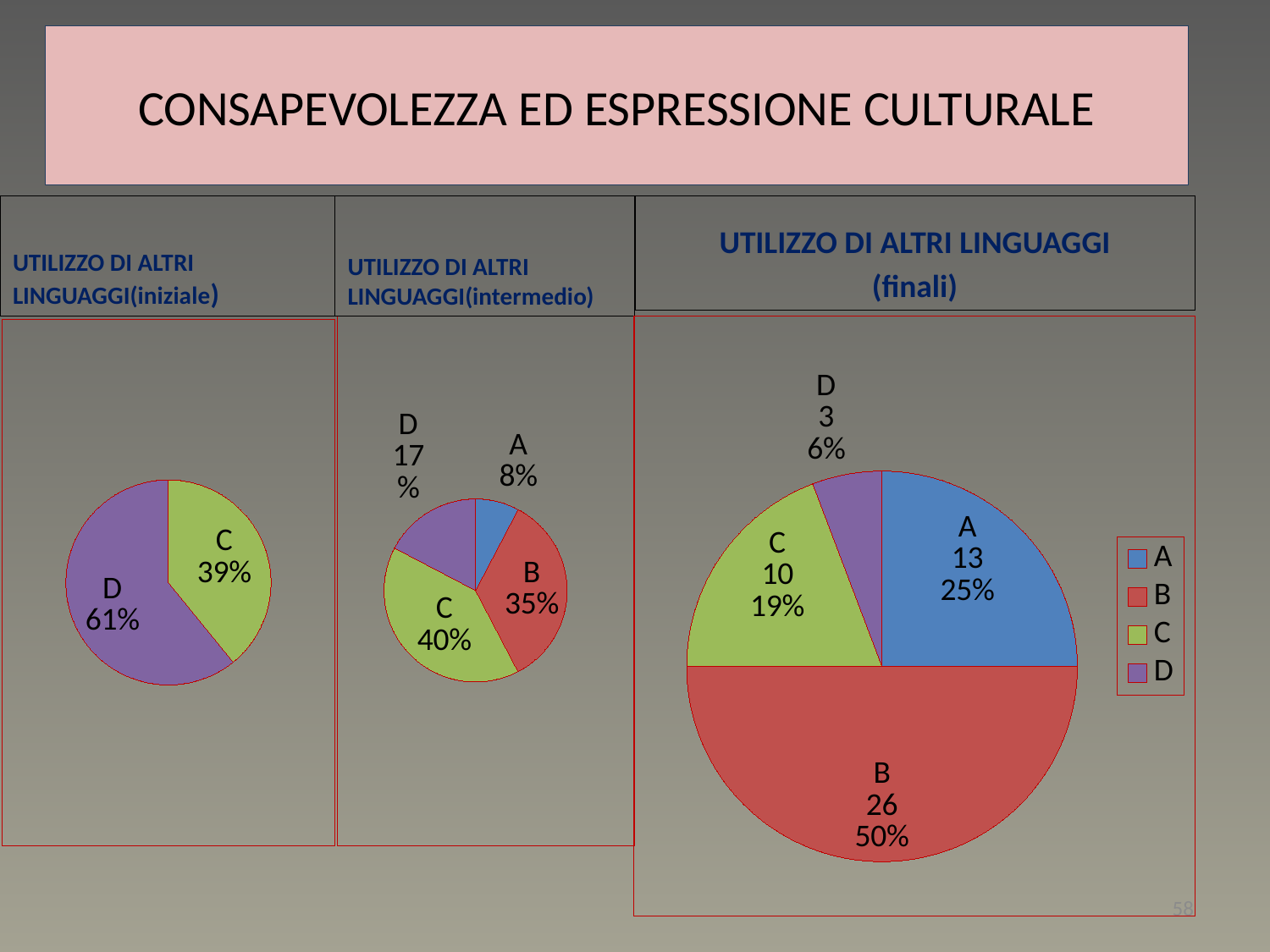
In the 'UTILIZZO DI ALTRI LINGUAGGI(intermedio)' chart, which category has the largest share? C How many entries does the legend of the 'UTILIZZO DI ALTRI LINGUAGGI (finali)' chart list? 4 In the 'UTILIZZO DI ALTRI LINGUAGGI(intermedio)' chart, what percentage is shown for B? 35% In the 'UTILIZZO DI ALTRI LINGUAGGI(iniziale)' chart, what percentage is shown for C? 39% In the 'UTILIZZO DI ALTRI LINGUAGGI (finali)' chart, which is larger, the value for A or the value for C? A In the 'UTILIZZO DI ALTRI LINGUAGGI(intermedio)' chart, which category has the smallest share? A What type of chart is the 'UTILIZZO DI ALTRI LINGUAGGI (finali)' chart? Pie chart In the 'UTILIZZO DI ALTRI LINGUAGGI (finali)' chart, what is the difference between the values for A and D? 10 In the 'UTILIZZO DI ALTRI LINGUAGGI(intermedio)' chart, how many categories are shown? 4 In the 'UTILIZZO DI ALTRI LINGUAGGI (finali)' chart, what percentage share does C have? 19% In the 'UTILIZZO DI ALTRI LINGUAGGI(iniziale)' chart, what percentage is shown for D? 61% In the 'UTILIZZO DI ALTRI LINGUAGGI (finali)' chart, what value is shown for B? 26